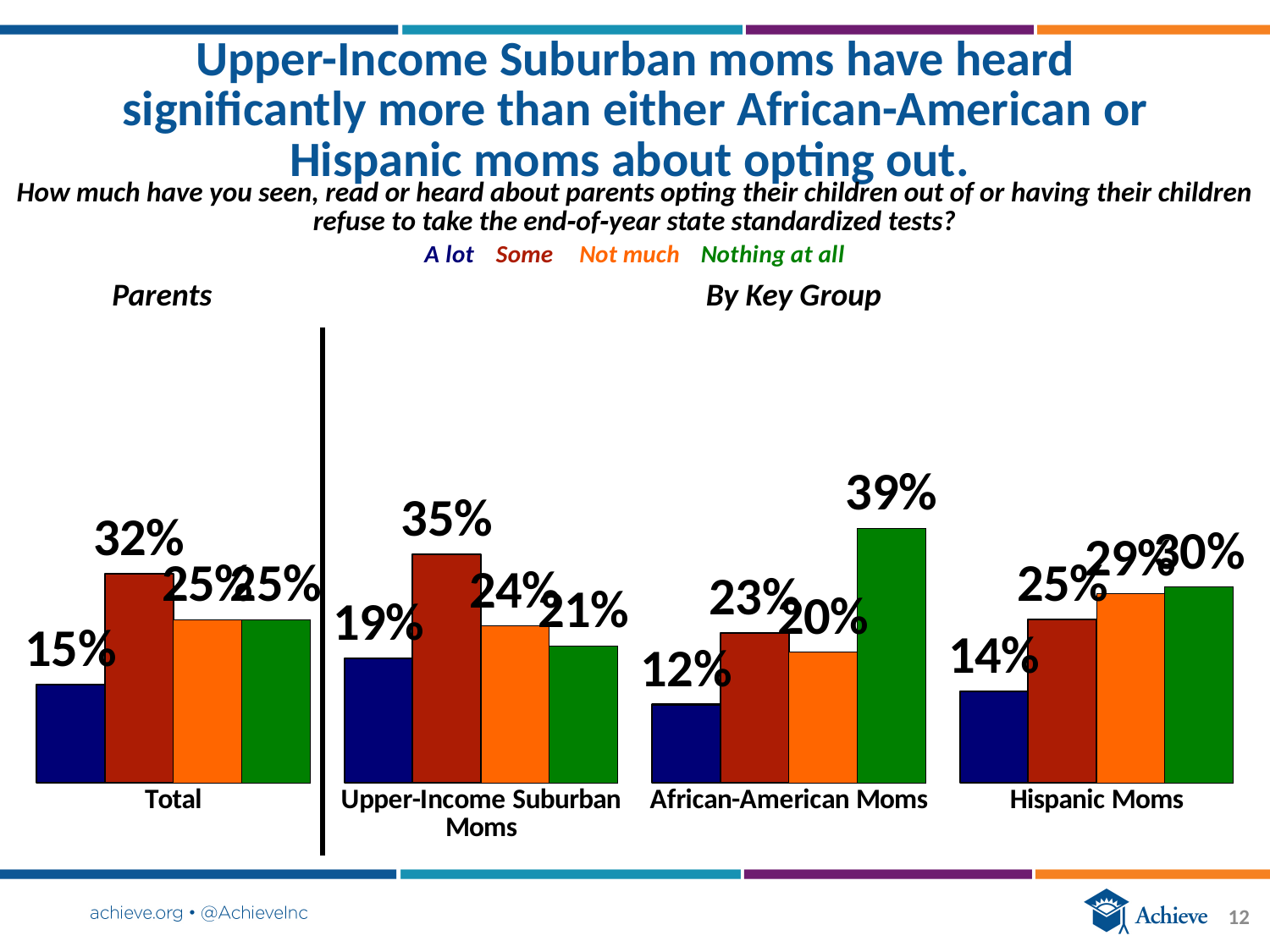
What is the difference between the "Nothing at all" values for African-American Moms and Upper-Income Suburban Moms? 18 percentage points Which colour represents the "Nothing at all" response in the chart? Green What percentage of African-American Moms said "Nothing at all"? 39% Which group has the highest "Some" value? Upper-Income Suburban Moms What percentage of Hispanic Moms said "A lot"? 14% What percentage of Upper-Income Suburban Moms said they have heard "A lot" about opting out? 19% How many groups are shown along the x axis of the chart? 4 What is the "Some" value for the Total group? 32% Which is larger: the "A lot" value for Upper-Income Suburban Moms or for Hispanic Moms? Upper-Income Suburban Moms How many response categories does the legend list? 4 Which group has the lowest "A lot" value? African-American Moms What type of chart is shown on the slide? Bar chart